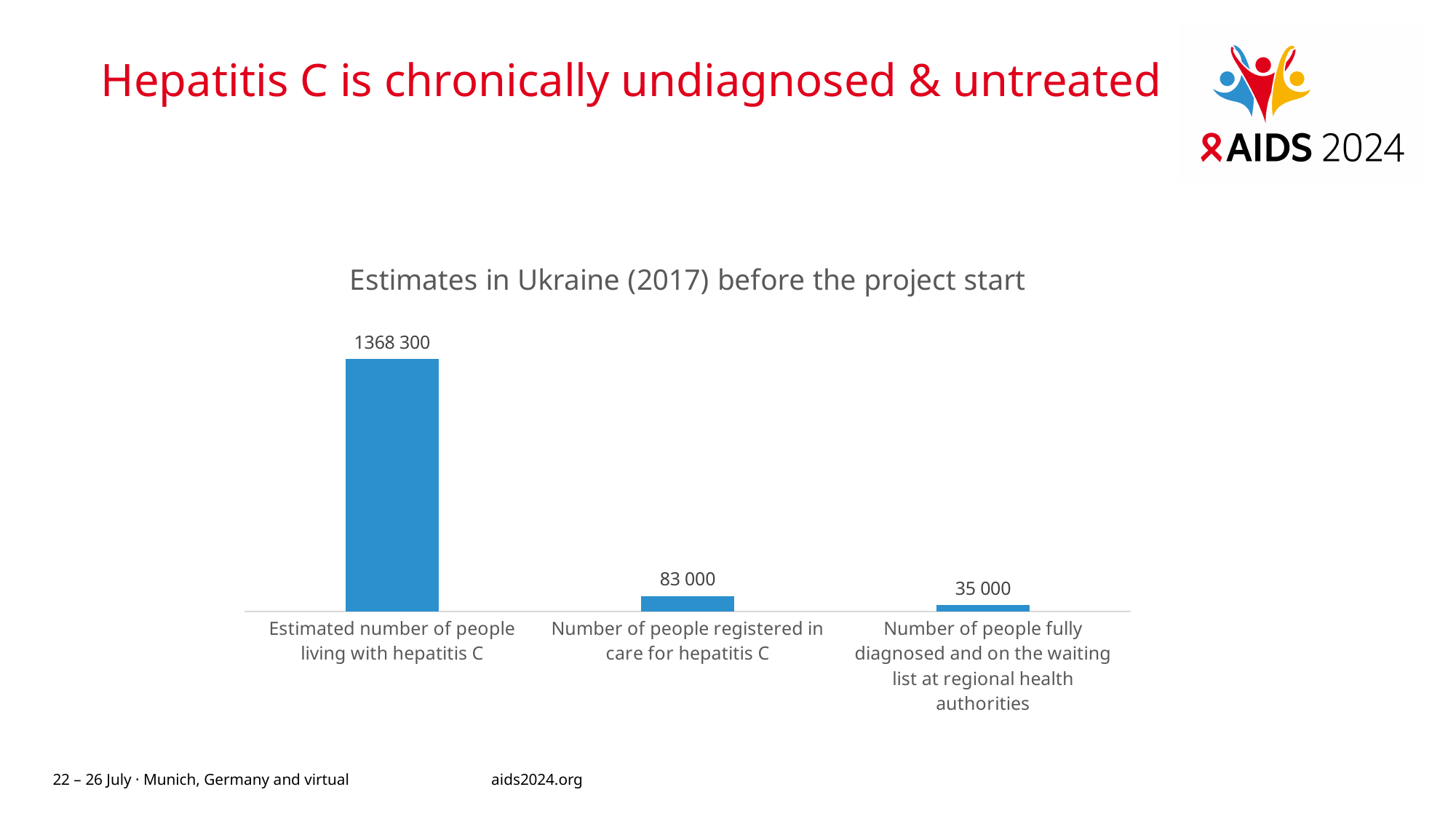
What is the estimated number of people living with hepatitis C? 1368 300 Do the values rise or fall from left to right across the categories? Fall What is the title of the chart? Estimates in Ukraine (2017) before the project start What kind of chart is shown on the slide? Bar chart Which is larger: the number of people registered in care for hepatitis C or the number of people fully diagnosed and on the waiting list? Number of people registered in care for hepatitis C What is the difference between the estimated number of people living with hepatitis C and the number of people registered in care? 1285 300 What is the number of people fully diagnosed and on the waiting list at regional health authorities? 35 000 Which category has the lowest value? Number of people fully diagnosed and on the waiting list at regional health authorities Which category has the highest value? Estimated number of people living with hepatitis C What is the number of people registered in care for hepatitis C? 83 000 How many categories are shown in the chart? 3 What is the difference between the number of people registered in care for hepatitis C and the number of people fully diagnosed and on the waiting list? 48 000